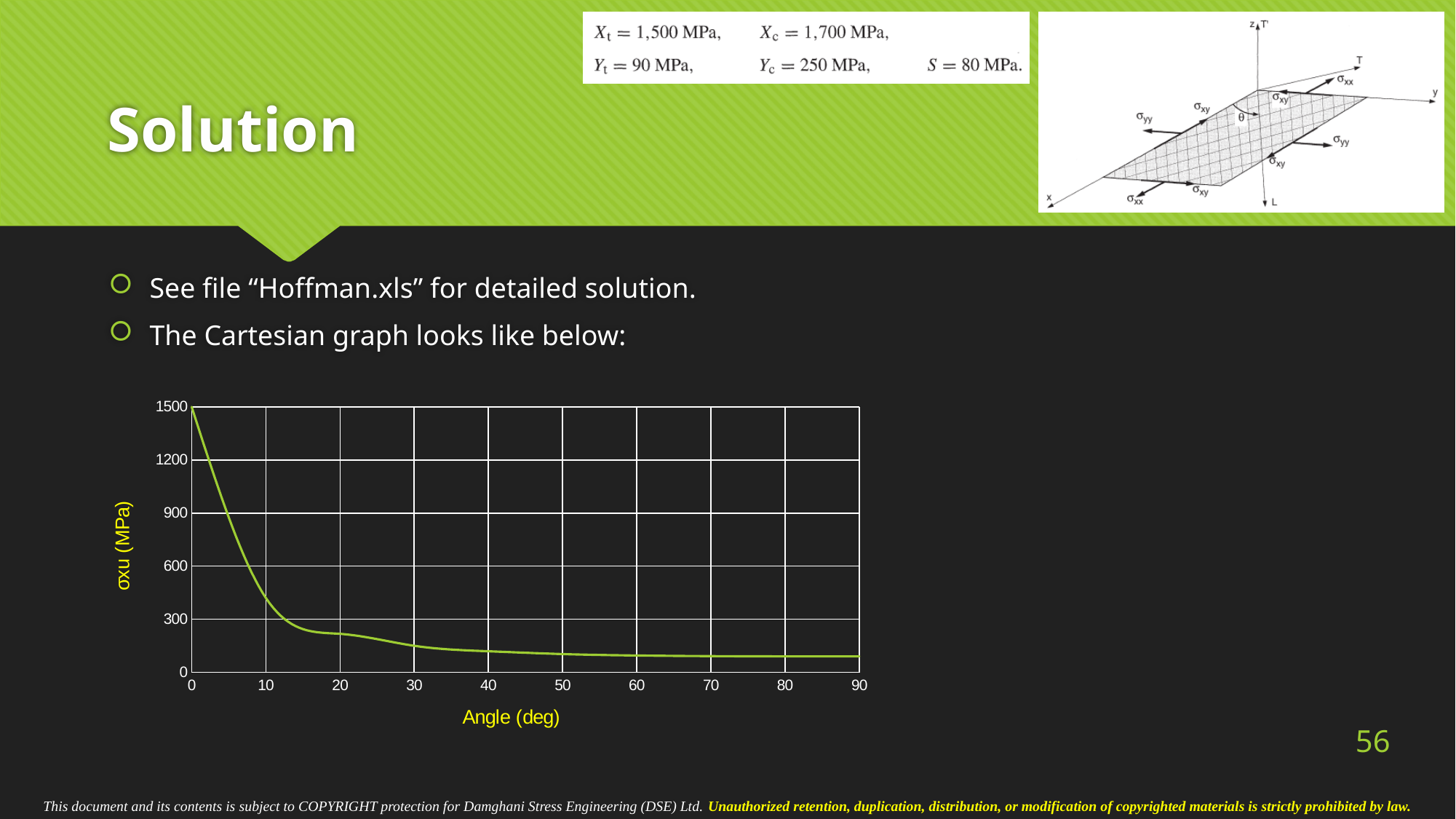
Which is larger, σxu at 10 degrees or σxu at 40 degrees? 10 degrees What is the title of the y axis of the chart? σxu (MPa) Is the value of σxu at 10 degrees greater or less than 300? greater Is the value of σxu at 20 degrees greater or less than 300? less What is the title of the x axis of the chart? Angle (deg) Does the value of σxu rise or fall as the angle increases from 0 to 90 degrees? fall Is the value of σxu at 10 degrees greater or less than 600? less What is the value of σxu at an angle of 0 degrees? 1500 What kind of chart is shown on the slide? line chart At which angle is σxu highest? 0 What is the maximum value shown on the y axis of the chart? 1500